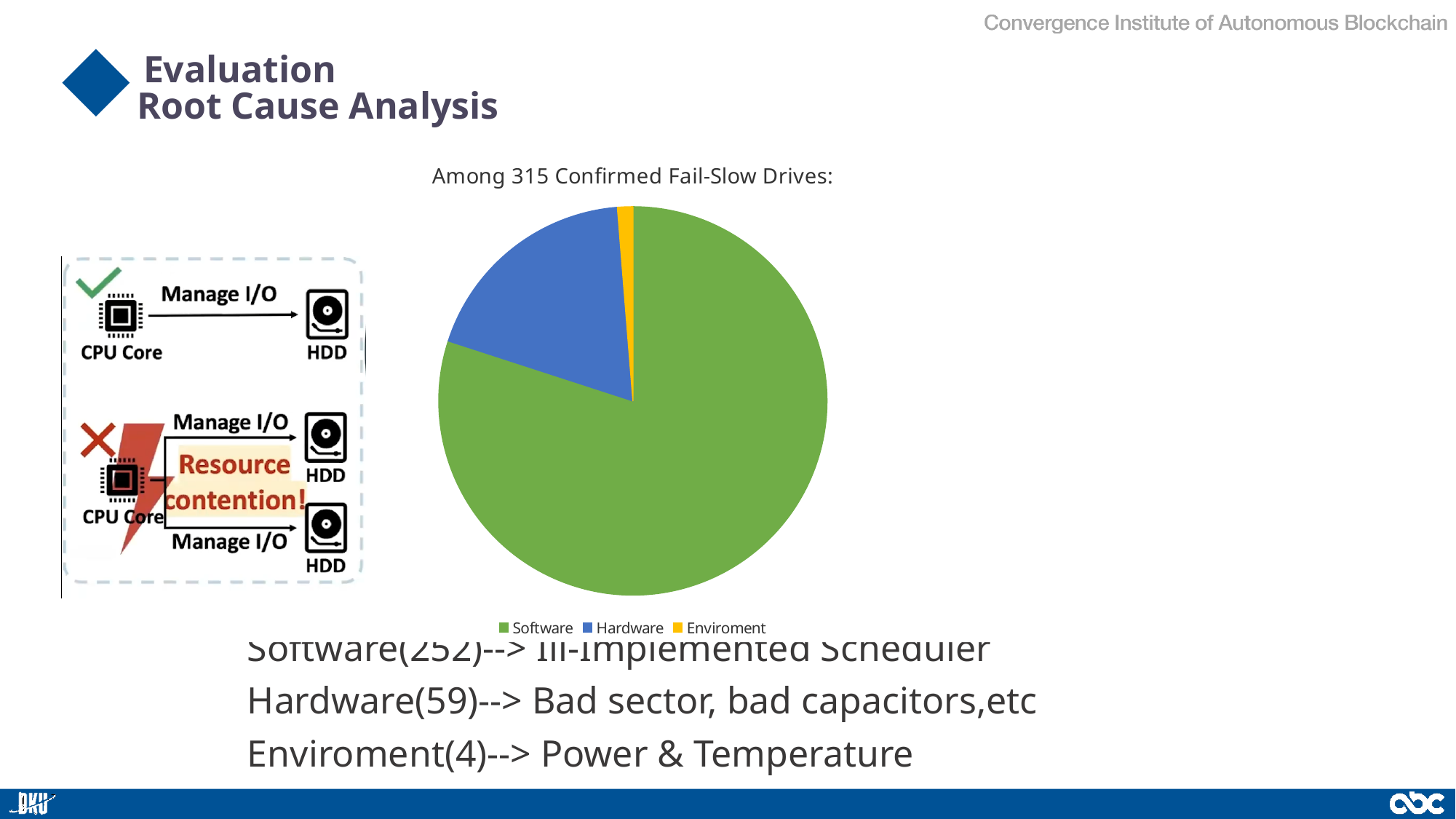
Which category has the largest slice of the pie chart? Software How many drives are attributed to Software according to the slide? 252 How many drives are attributed to Hardware according to the slide? 59 What is the difference between the Software count and the Hardware count? 193 What colour is the Hardware slice in the pie chart? blue What kind of chart is shown on the slide? pie chart Which category has the smallest slice of the pie chart? Enviroment How many categories does the pie chart legend list? 3 Which slice is larger, Hardware or Enviroment? Hardware What share of the 315 confirmed fail-slow drives does the Software slice represent? 80% How many drives are attributed to Enviroment according to the slide? 4 What is the title of the pie chart? Among 315 Confirmed Fail-Slow Drives: